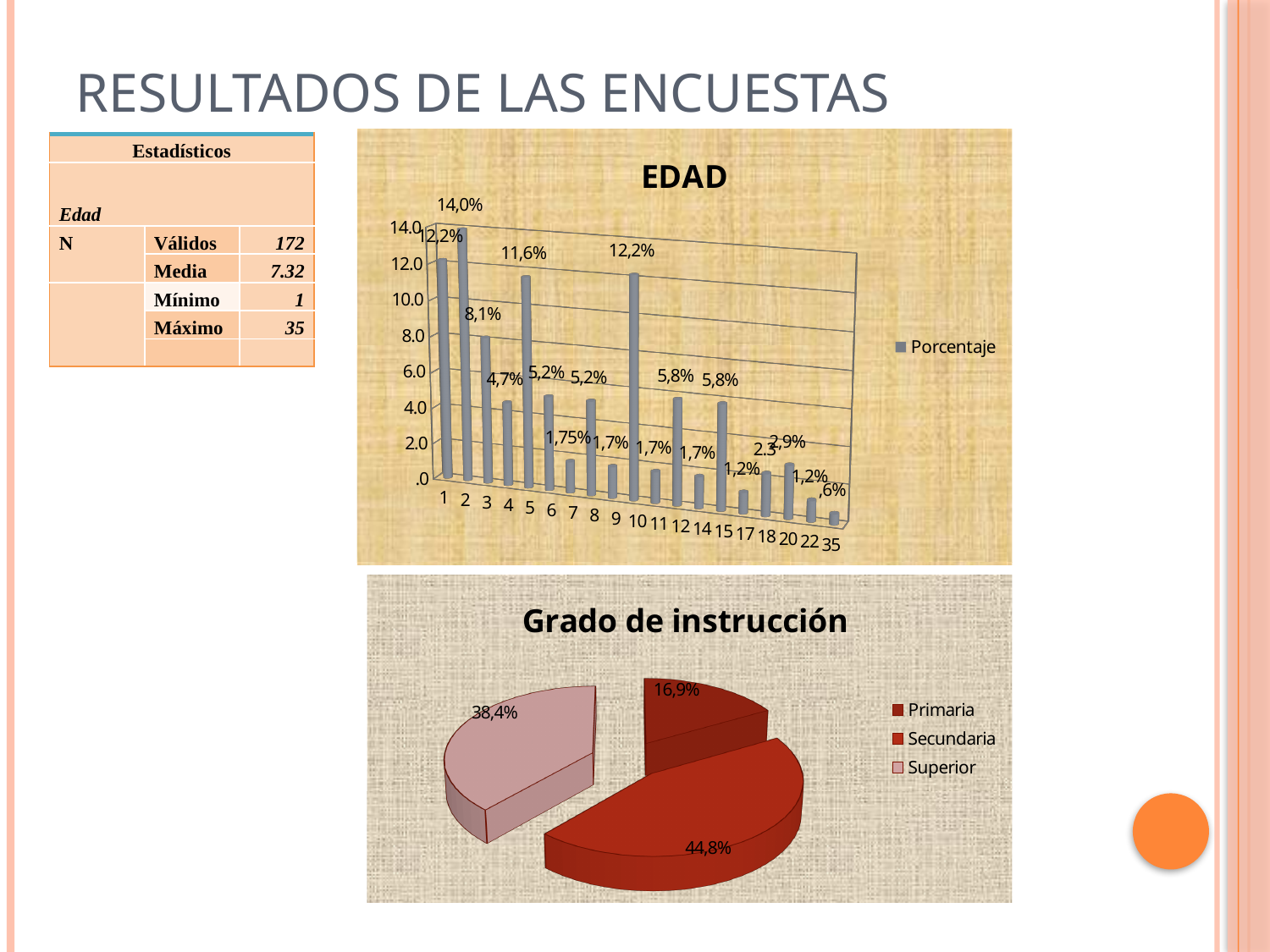
In the EDAD chart, what is the value for category 5? 11,6% In the EDAD chart, what is the value for category 3? 8,1% What kind of chart is the Grado de instrucción chart? pie chart What kind of chart is the EDAD chart? bar chart What is the name of the series in the legend of the EDAD chart? Porcentaje In the EDAD chart, which category has the highest value? 2 In the Grado de instrucción chart, what is the difference between the Secundaria and Superior shares? 6,4% In the EDAD chart, which category has the lowest value? 35 In the Grado de instrucción chart, what is the share for Secundaria? 44,8% In the Grado de instrucción chart, which category has the smallest slice? Primaria How many series does the legend of the EDAD chart list? 1 In the EDAD chart, what is the highest value shown? 14,0%